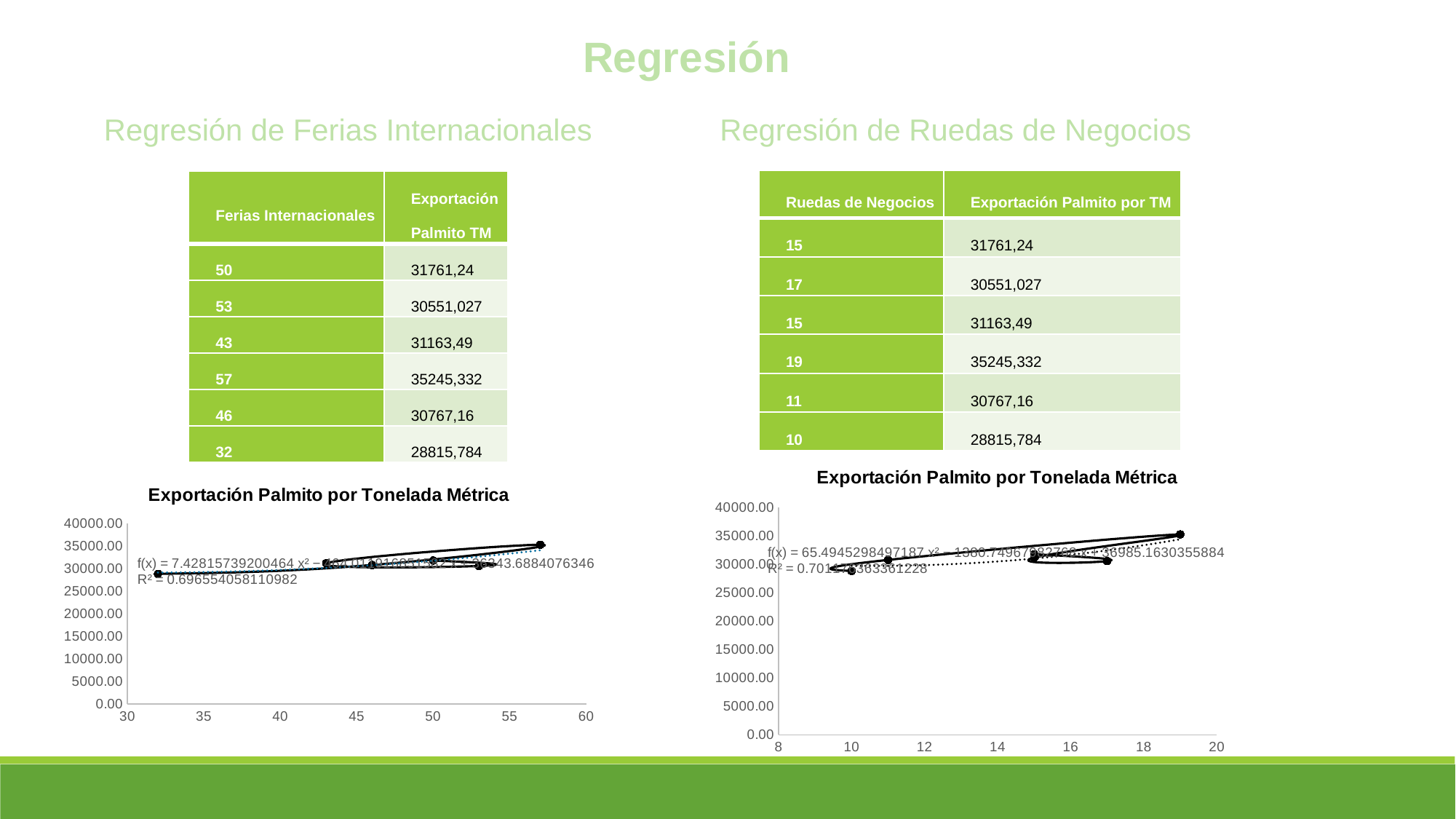
What kind of chart is the left chart titled 'Exportación Palmito por Tonelada Métrica' under 'Regresión de Ferias Internacionales'? Scatter chart What is the title of the right chart under 'Regresión de Ruedas de Negocios'? Exportación Palmito por Tonelada Métrica How many data points are plotted on the left chart (Regresión de Ferias Internacionales)? 6 How many data points are plotted on the right chart (Regresión de Ruedas de Negocios)? 6 On the right chart (Regresión de Ruedas de Negocios), at which x value is the highest plotted point? 19 On the right chart (Regresión de Ruedas de Negocios), do the plotted values generally rise or fall as x increases? rise What is the R² value shown on the left chart (Regresión de Ferias Internacionales)? 0.696554058110982 On the right chart (Regresión de Ruedas de Negocios), at which x value is the lowest plotted point? 10 On the left chart (Regresión de Ferias Internacionales), at which x value is the lowest plotted point? 32 On the left chart (Regresión de Ferias Internacionales), at which x value is the highest plotted point? 57 On the left chart (Regresión de Ferias Internacionales), is the value for x = 57 greater or less than 30000? greater On the right chart (Regresión de Ruedas de Negocios), is the value for x = 10 greater or less than 30000? less